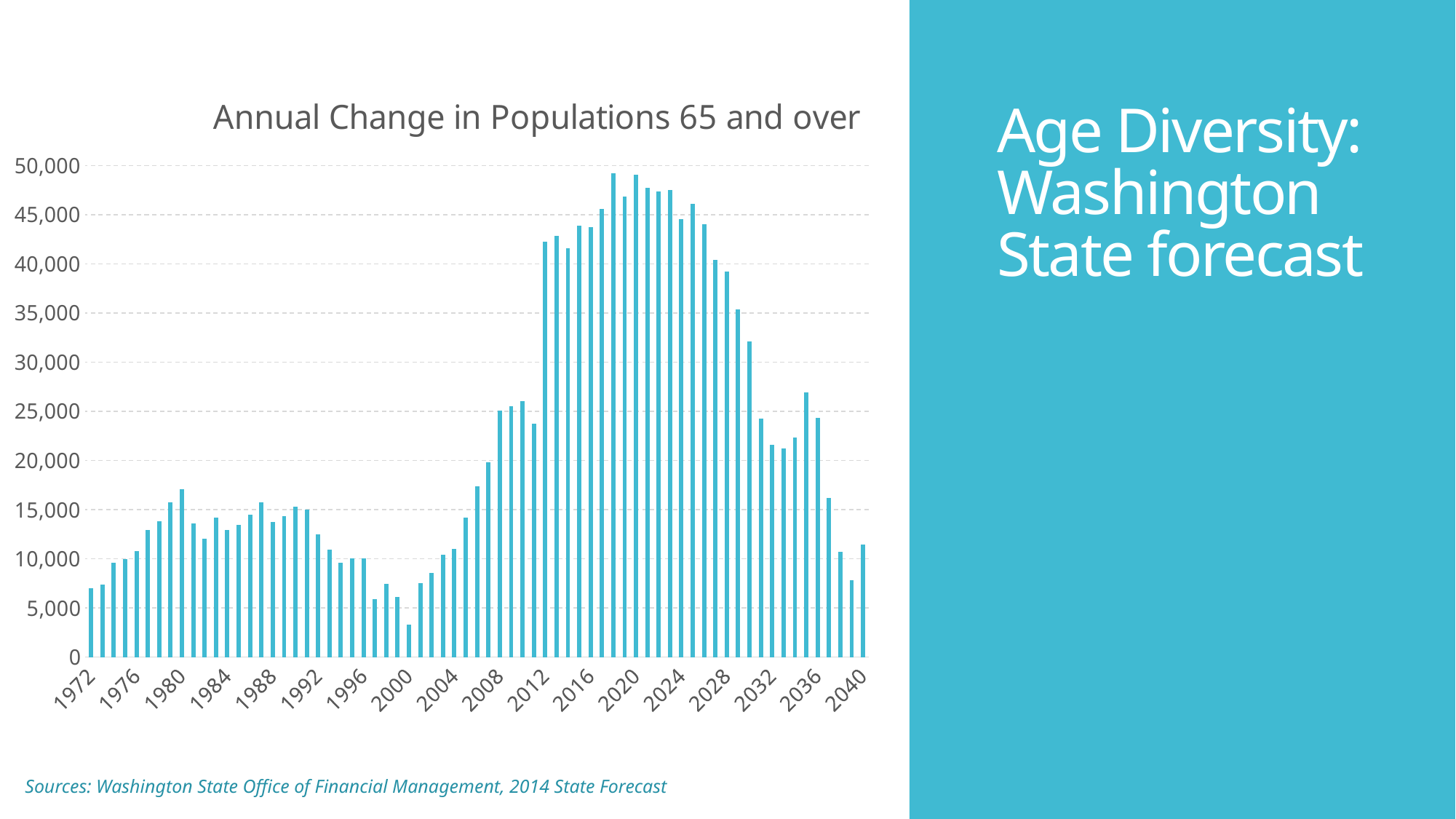
Which year has the lowest annual change in population 65 and over? 2000 What is the title of the chart? Annual Change in Populations 65 and over What kind of chart is shown on the slide? bar chart Is the value for 2012 greater or less than 40,000? greater Which year has the larger value, 1980 or 2012? 2012 Do the values rise or fall from 2000 to 2012? rise Is the value for 1984 greater or less than 15,000? less Is the value for 2040 greater or less than 15,000? less Do the values rise or fall from 2020 to 2040? fall Which year has the larger value, 2000 or 2040? 2040